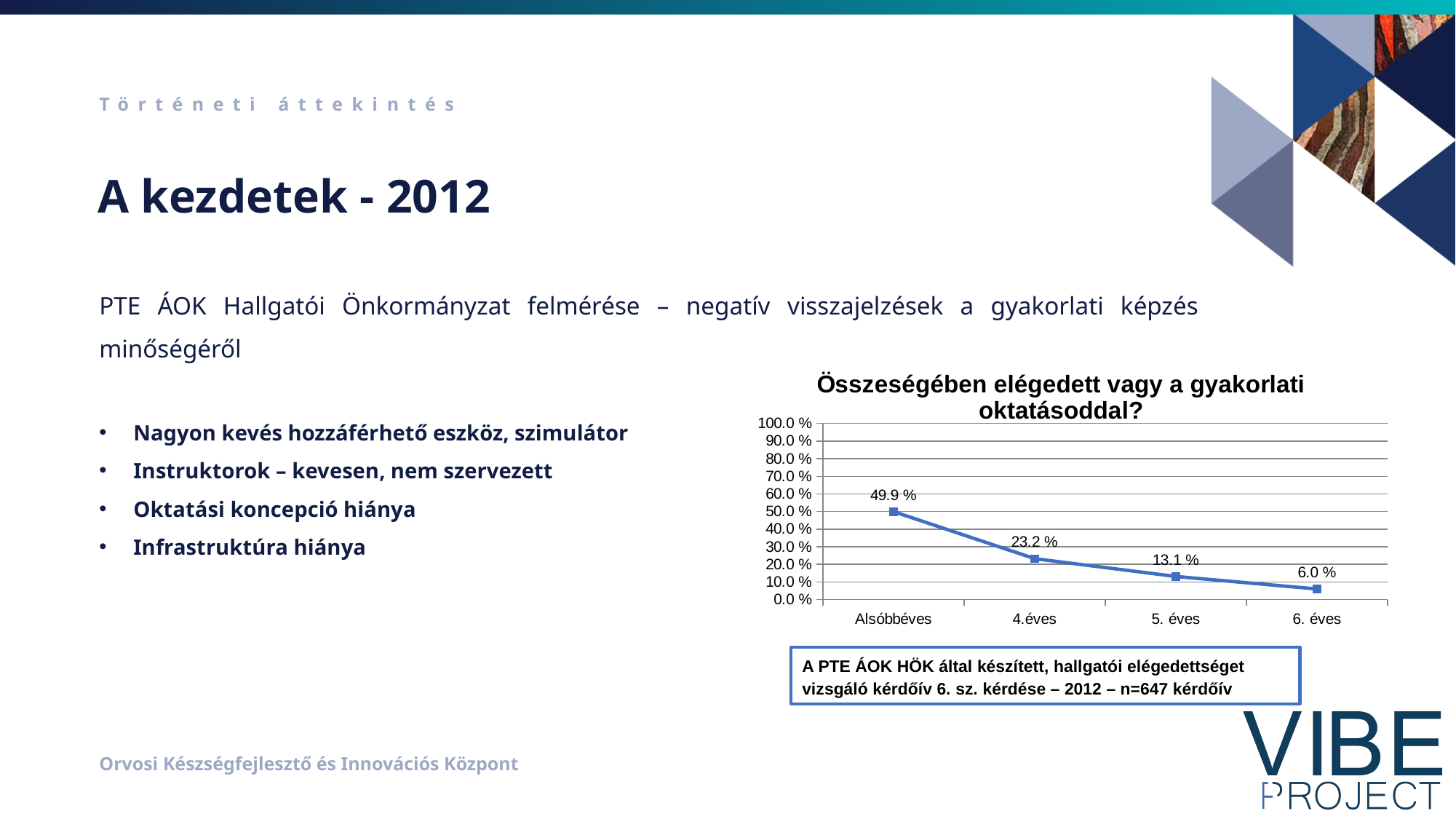
What is the value for 6. éves? 6.0 % What is the value for Alsóbbéves? 49.9 % Do the values rise or fall from Alsóbbéves to 6. éves? fall Which category has the highest value? Alsóbbéves Is the value for Alsóbbéves greater or less than 40.0 %? greater Which is larger, the value for 5. éves or the value for 6. éves? 5. éves What is the value for 4.éves? 23.2 % How many categories are shown on the x axis? 4 What kind of chart is shown? line chart What is the value for 5. éves? 13.1 % Which category has the lowest value? 6. éves What is the difference between the values for Alsóbbéves and 4.éves? 26.7 %